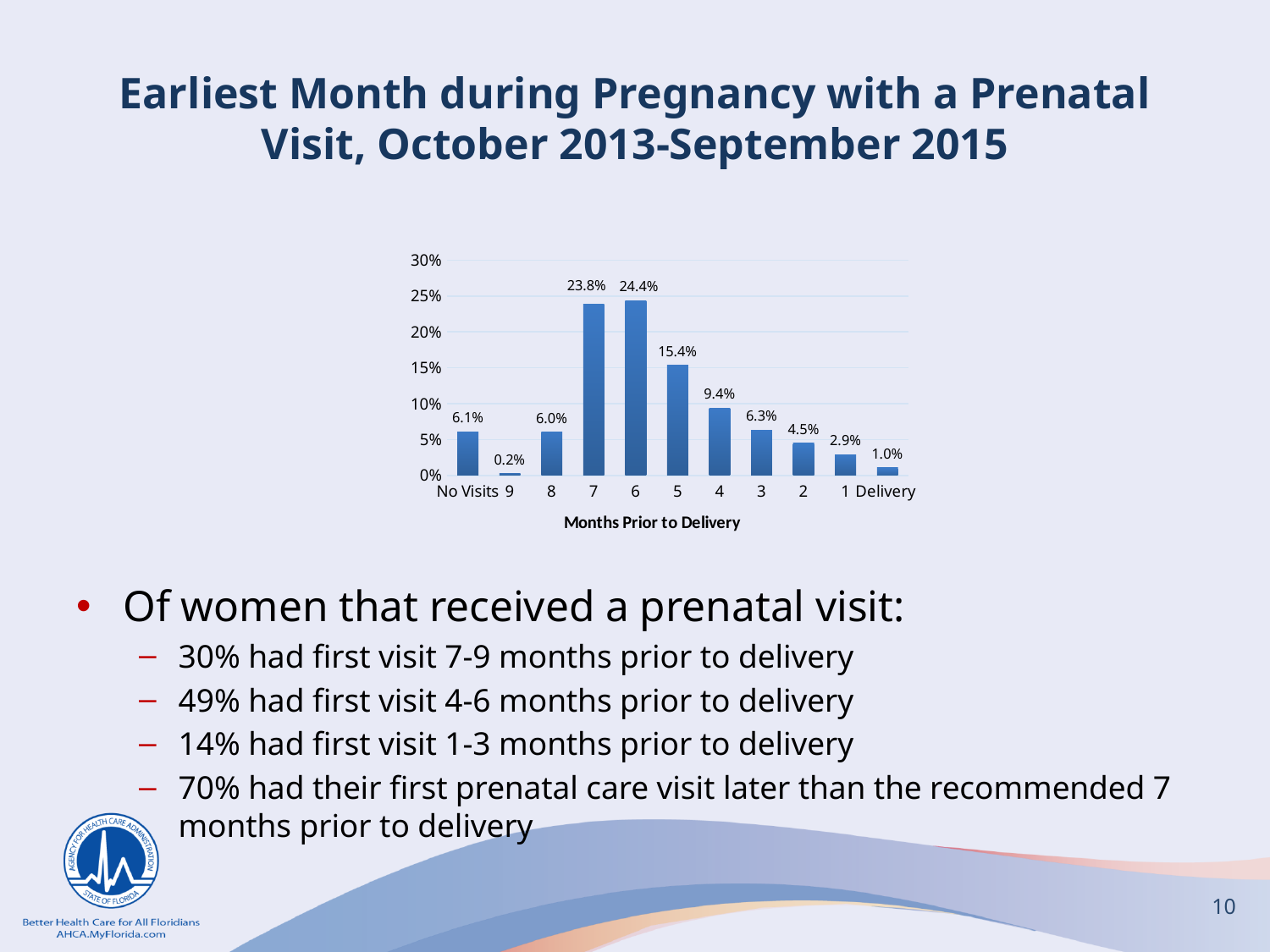
What type of chart is shown on the slide? bar chart Is the value for 5 months prior to delivery greater or less than 20%? less Which category has the lowest value? 9 How many categories are shown on the x axis? 11 What is the title of the x axis? Months Prior to Delivery Which category has the highest value? 6 What is the value for 6 months prior to delivery? 24.4% What is the value for the 'Delivery' category? 1.0% Which is larger, the value for 4 months or the value for 3 months prior to delivery? 4 What is the value for 9 months prior to delivery? 0.2% What is the value for the 'No Visits' category? 6.1% What is the difference between the values for 7 and 5 months prior to delivery? 8.4%